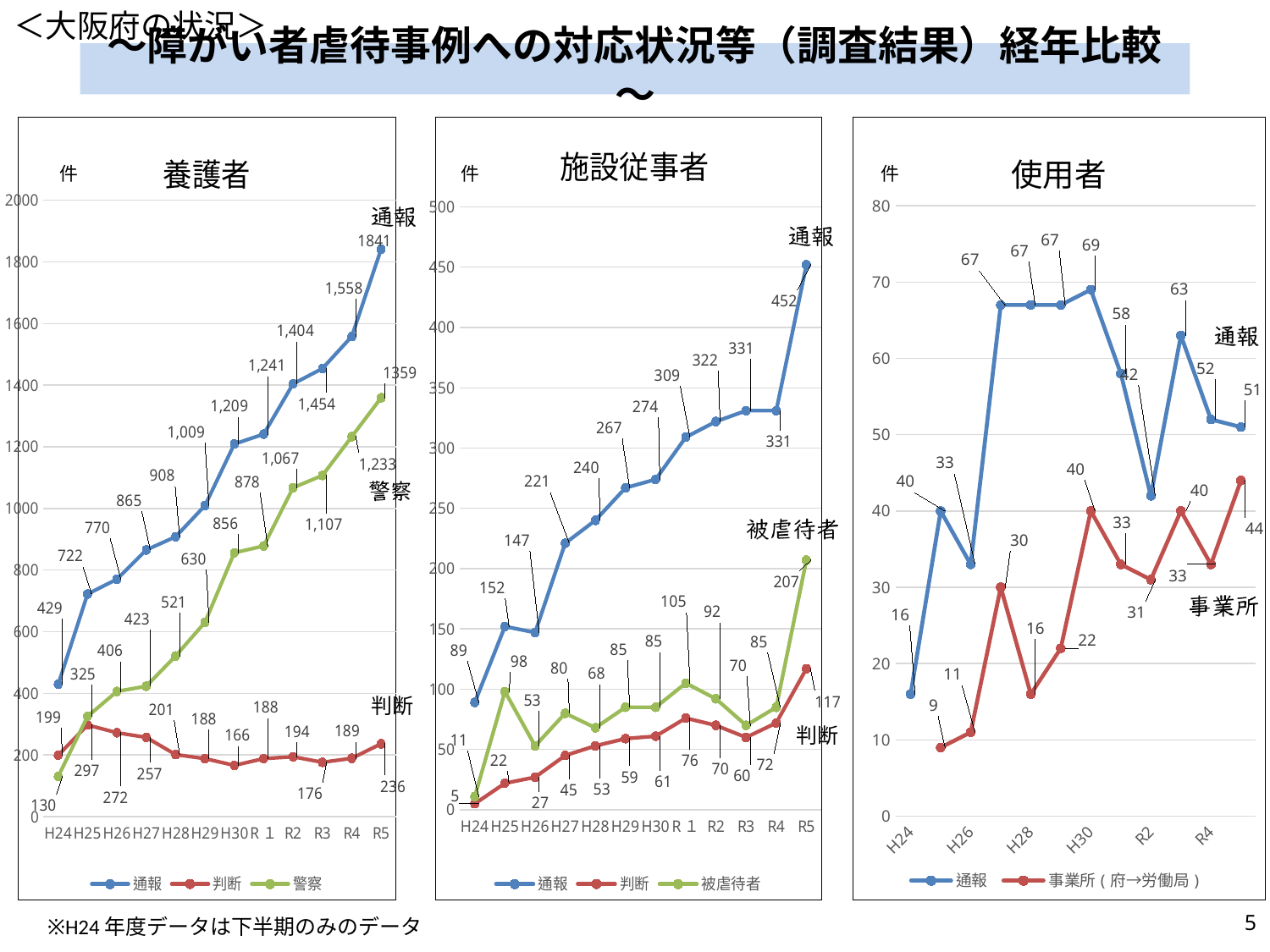
In the 使用者 chart, what is the 事業所 value for H28? 16 In the 養護者 chart, what is the difference between the 通報 value and the 警察 value for R5? 482 In the 養護者 chart, what is the 警察 value for R4? 1,233 In the 施設従事者 chart, which is larger for R1, 判断 or 被虐待者? 被虐待者 In the 施設従事者 chart, how many years are plotted on the x axis? 12 What kind of chart is the 使用者 chart? Line chart In the 使用者 chart, what is the 通報 value for H30? 69 In the 施設従事者 chart, what is the 通報 value for R5? 452 In the 養護者 chart, which year has the lowest 判断 value? H30 In the 養護者 chart, what is the 通報 value for R5? 1841 In the 養護者 chart, how many series does the legend list? 3 In the 施設従事者 chart, what is the 被虐待者 value for H25? 98